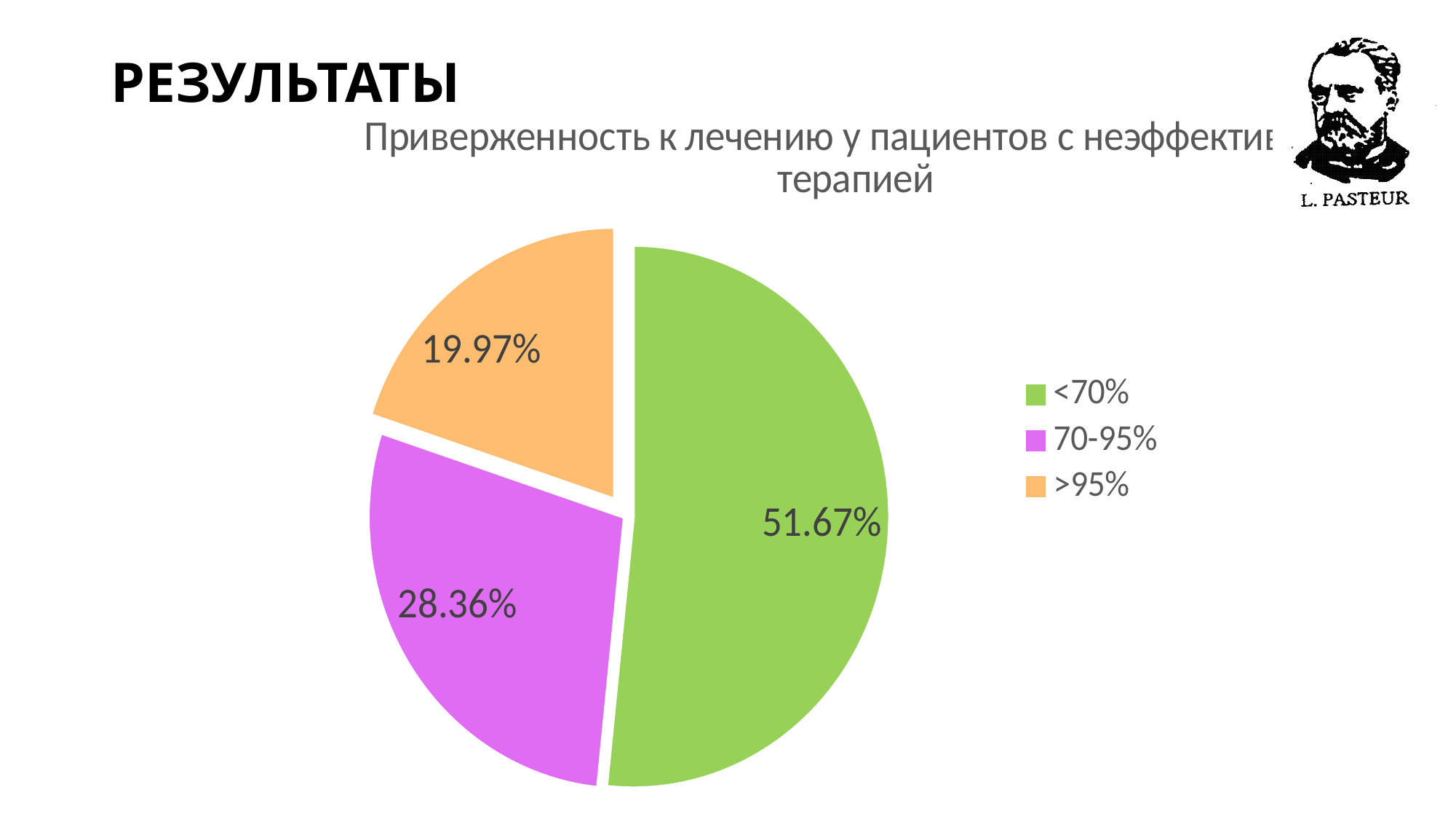
What kind of chart is shown on the slide? Pie chart What share of the pie does the ">95%" slice represent? 19.97% What share of the pie does the "70-95%" slice represent? 28.36% How many entries does the legend list? 3 How many slices does the pie chart have? 3 What is the difference in percentage points between the "70-95%" slice and the ">95%" slice? 8.39 What is the difference in percentage points between the "<70%" slice and the "70-95%" slice? 23.31 What share of the pie does the "<70%" slice represent? 51.67% Which category has the smallest slice of the pie? >95% What colour is the ">95%" slice in the pie chart? Orange Which slice is larger: "70-95%" or ">95%"? 70-95% Which category has the largest slice of the pie? <70%